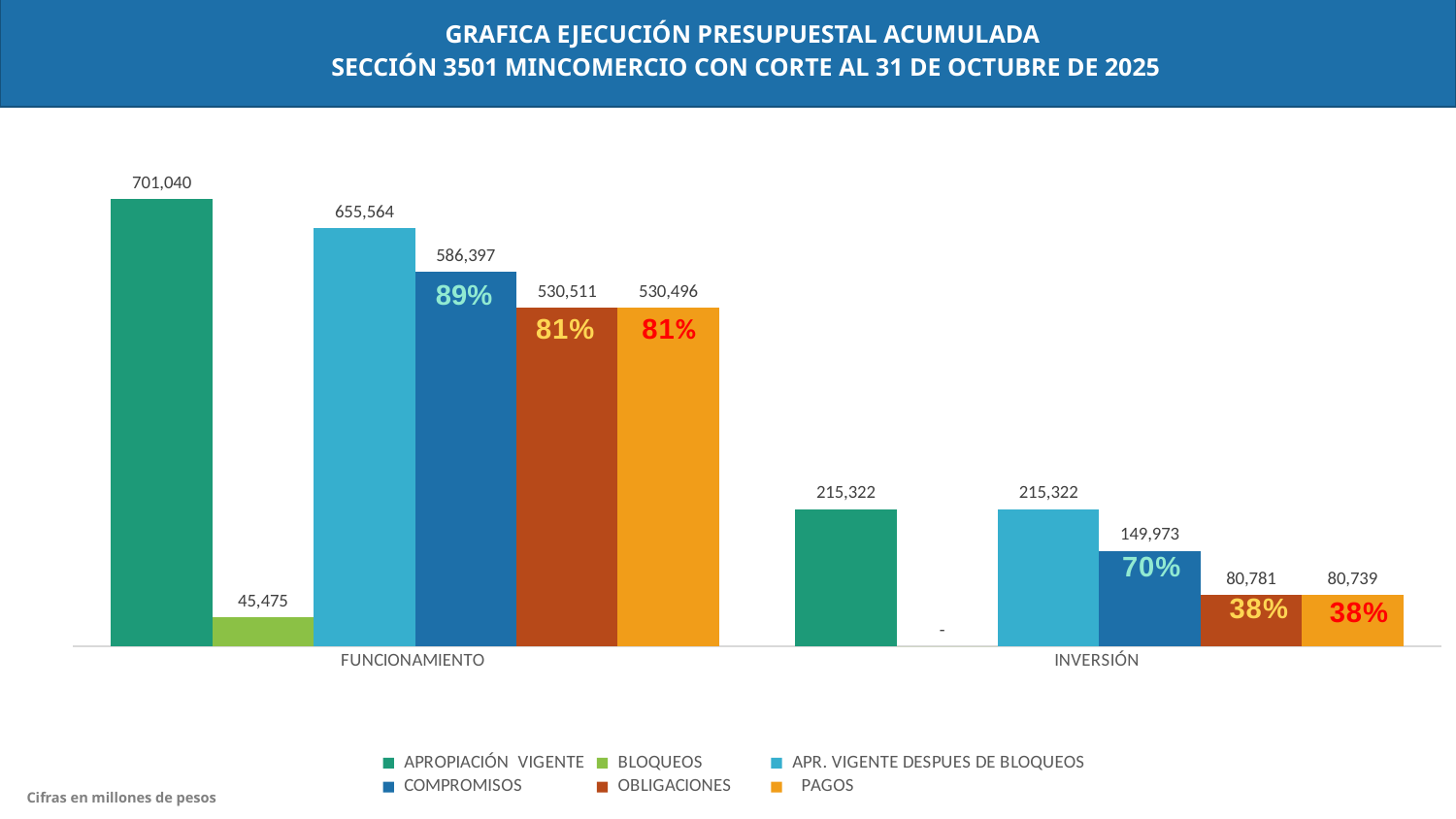
What is the value of OBLIGACIONES for INVERSIÓN? 80,781 How many categories are shown on the x axis? 2 What is the value of APROPIACIÓN VIGENTE for FUNCIONAMIENTO? 701,040 Which is larger: COMPROMISOS for FUNCIONAMIENTO or APROPIACIÓN VIGENTE for INVERSIÓN? COMPROMISOS for FUNCIONAMIENTO How many series does the legend list? 6 What is the value of PAGOS for FUNCIONAMIENTO? 530,496 What is the difference between APROPIACIÓN VIGENTE and APR. VIGENTE DESPUES DE BLOQUEOS for FUNCIONAMIENTO? 45,476 What percentage label is shown on the COMPROMISOS bar for INVERSIÓN? 70% What is the difference between COMPROMISOS and OBLIGACIONES for FUNCIONAMIENTO? 55,886 What is the value of COMPROMISOS for INVERSIÓN? 149,973 What is the value of BLOQUEOS for FUNCIONAMIENTO? 45,475 Which series has the lowest value in the FUNCIONAMIENTO group? BLOQUEOS